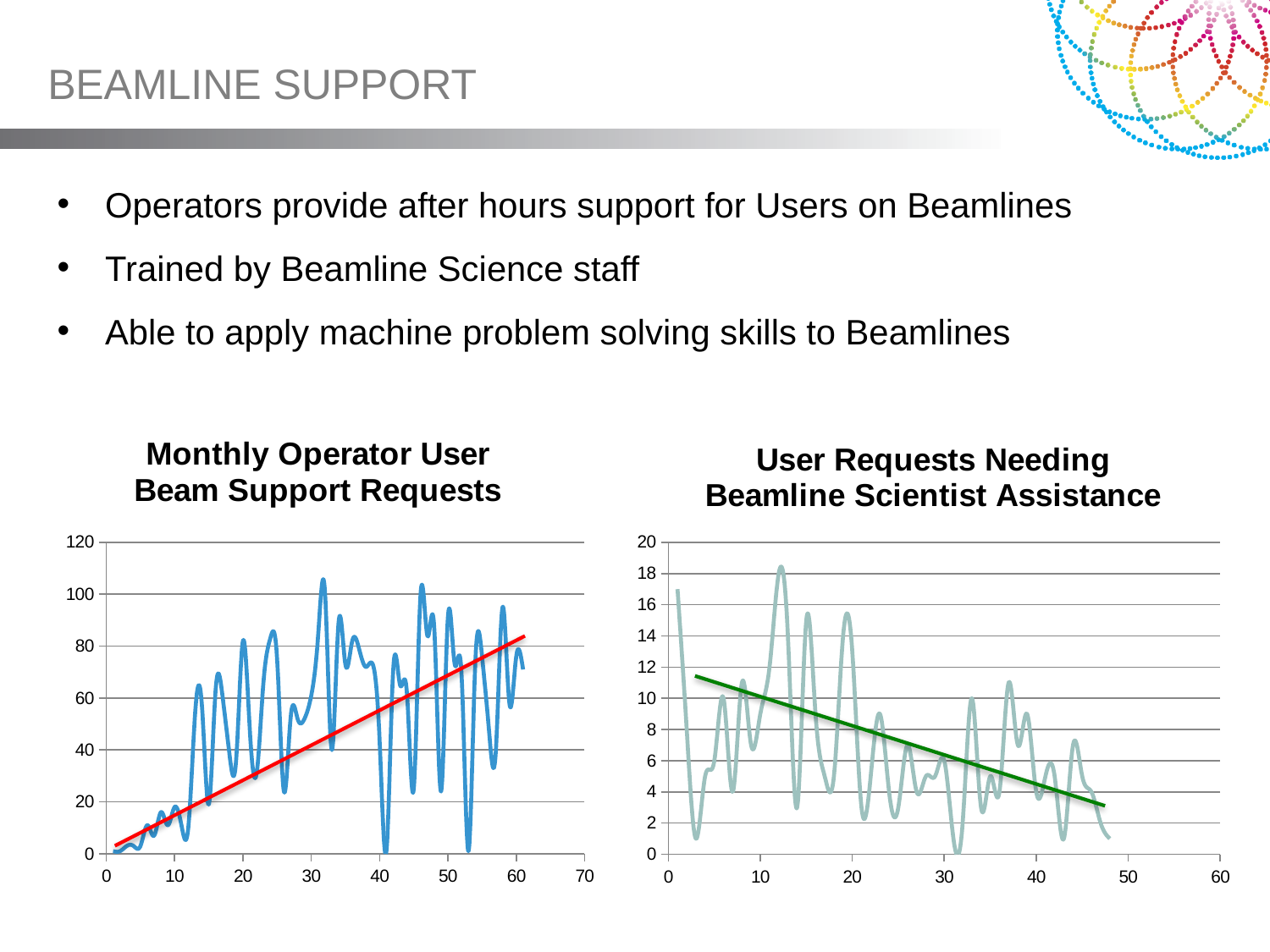
How many charts are shown on the slide? 2 In the "Monthly Operator User Beam Support Requests" chart, is the value at x = 41 greater or less than 20? less What is the maximum value shown on the y axis of the "Monthly Operator User Beam Support Requests" chart? 120 In the "User Requests Needing Beamline Scientist Assistance" chart, do the values generally rise or fall along the x axis? fall What kind of chart is the "User Requests Needing Beamline Scientist Assistance" chart? line chart What kind of chart is the "Monthly Operator User Beam Support Requests" chart? line chart In the "User Requests Needing Beamline Scientist Assistance" chart, is the value at x = 31 greater or less than 4? less In the "Monthly Operator User Beam Support Requests" chart, do the values generally rise or fall along the x axis? rise In the "User Requests Needing Beamline Scientist Assistance" chart, is the highest peak of the line greater or less than 16? greater What is the maximum value shown on the y axis of the "User Requests Needing Beamline Scientist Assistance" chart? 20